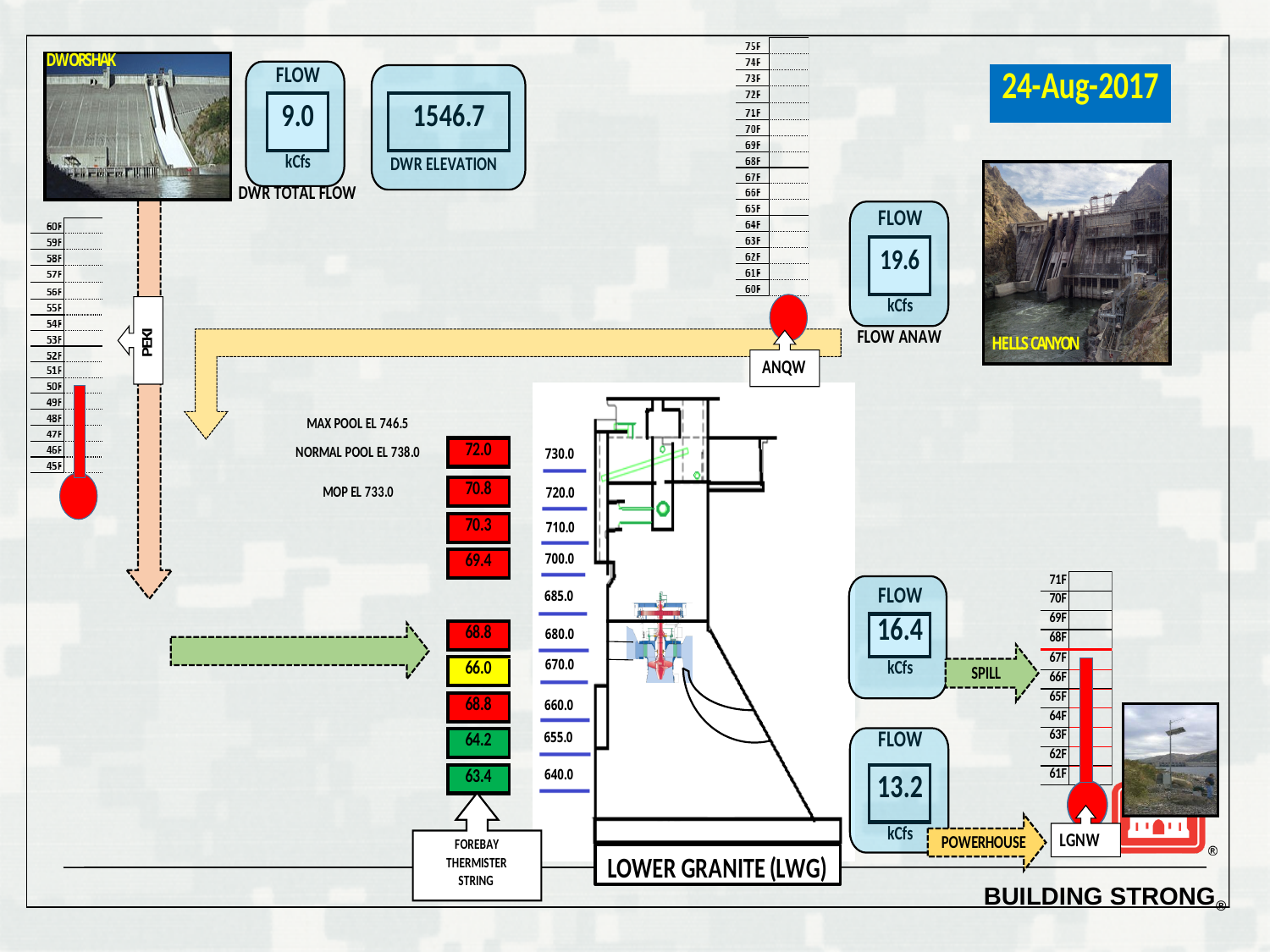
In the forebay thermistor string on the Lower Granite diagram, what is the topmost temperature reading? 72.0 What is the DWR elevation value shown on the slide? 1546.7 What is the lowest temperature shown in the forebay thermistor string? 63.4 What is the highest temperature shown in the forebay thermistor string? 72.0 In the forebay thermistor string, what is the bottommost temperature reading? 63.4 Which is larger, the spill flow (16.4 kCfs) or the powerhouse flow (13.2 kCfs) at Lower Granite? Spill flow What is the difference between the highest and lowest readings in the forebay thermistor string? 8.6 How many temperature readings are shown in the forebay thermistor string? 9 What is the flow value shown for FLOW ANAW? 19.6 kCfs In the forebay thermistor string, which reading is shown in yellow? 66.0 What is the DWR total flow value shown in the Dworshak flow box? 9.0 kCfs What date is shown on the slide? 24-Aug-2017